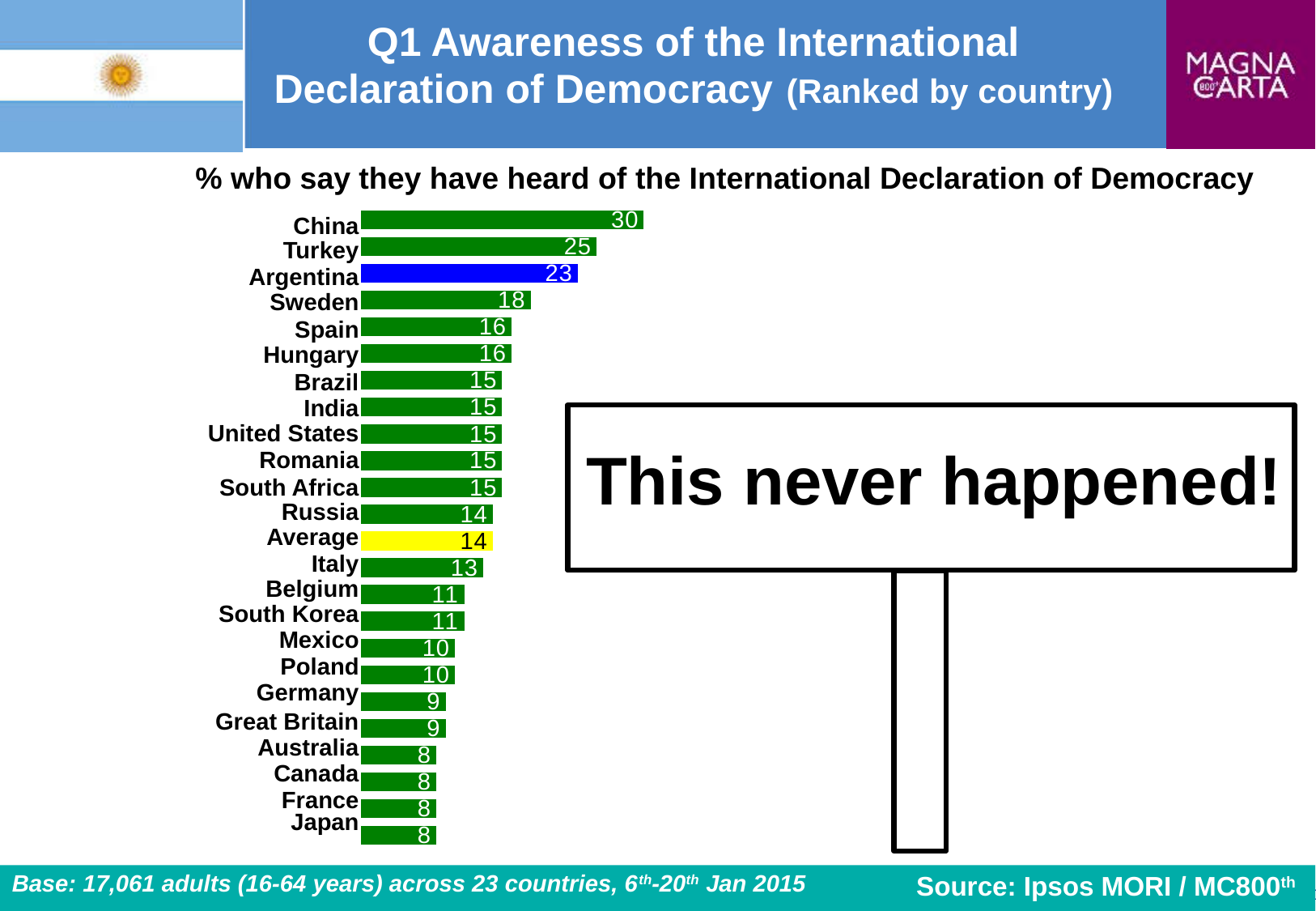
How many bars are plotted in the chart, including the Average bar? 24 Which country has the highest percentage who say they have heard of the International Declaration of Democracy? China Which country's bar is coloured blue instead of green? Argentina What is the value shown for Japan? 8 What is the value shown for Argentina? 23 What type of chart is shown on the slide? Bar chart What is the value shown for the Average bar? 14 Which has a higher value, Sweden or Italy? Sweden What percentage of people in China say they have heard of the International Declaration of Democracy? 30 Which has a higher value, Russia or Turkey? Turkey What is the difference between the values for China and Turkey? 5 What is the difference between the values for Argentina and the Average? 9